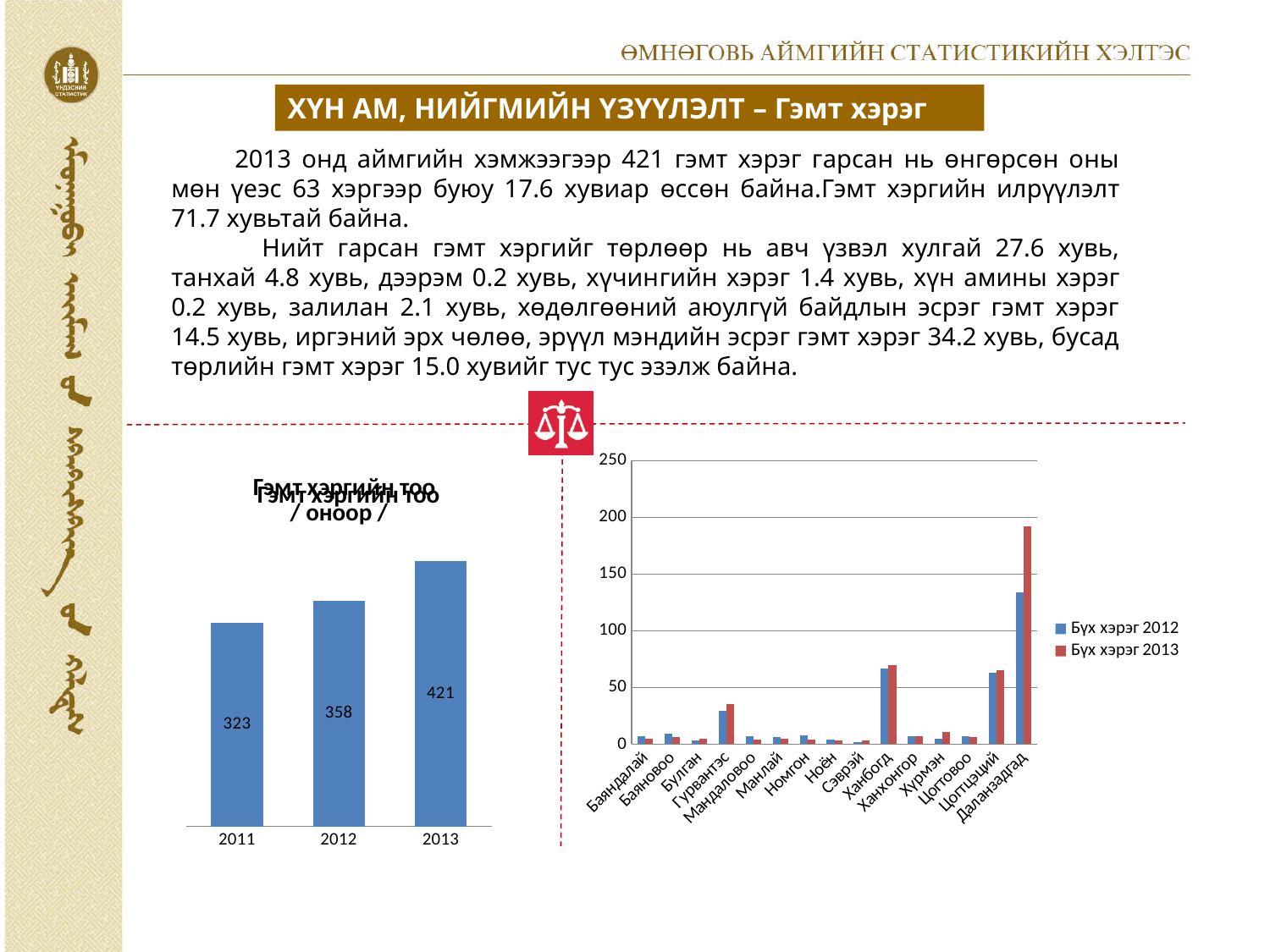
In the chart on the right side of the slide, is the Бүх хэрэг 2013 value for Даланзадгад greater or less than 150? greater In the chart on the right side of the slide, which category has the highest value for Бүх хэрэг 2013? Даланзадгад In the left chart titled 'Гэмт хэргийн тоо / оноор /', do the values rise or fall from 2011 to 2013? rise In the left chart titled 'Гэмт хэргийн тоо / оноор /', which year has the lowest value? 2011 What kind of chart is the chart on the right side of the slide? bar chart In the left chart titled 'Гэмт хэргийн тоо / оноор /', what is the value for 2013? 421 In the chart on the right side of the slide, how many series does the legend list? 2 In the chart on the right side of the slide, how many categories are shown on the x axis? 15 In the left chart titled 'Гэмт хэргийн тоо / оноор /', how many years are shown? 3 In the left chart titled 'Гэмт хэргийн тоо / оноор /', what is the difference between the 2013 and 2012 values? 63 In the left chart titled 'Гэмт хэргийн тоо / оноор /', what is the value for 2011? 323 In the left chart titled 'Гэмт хэргийн тоо / оноор /', which year has the highest value? 2013